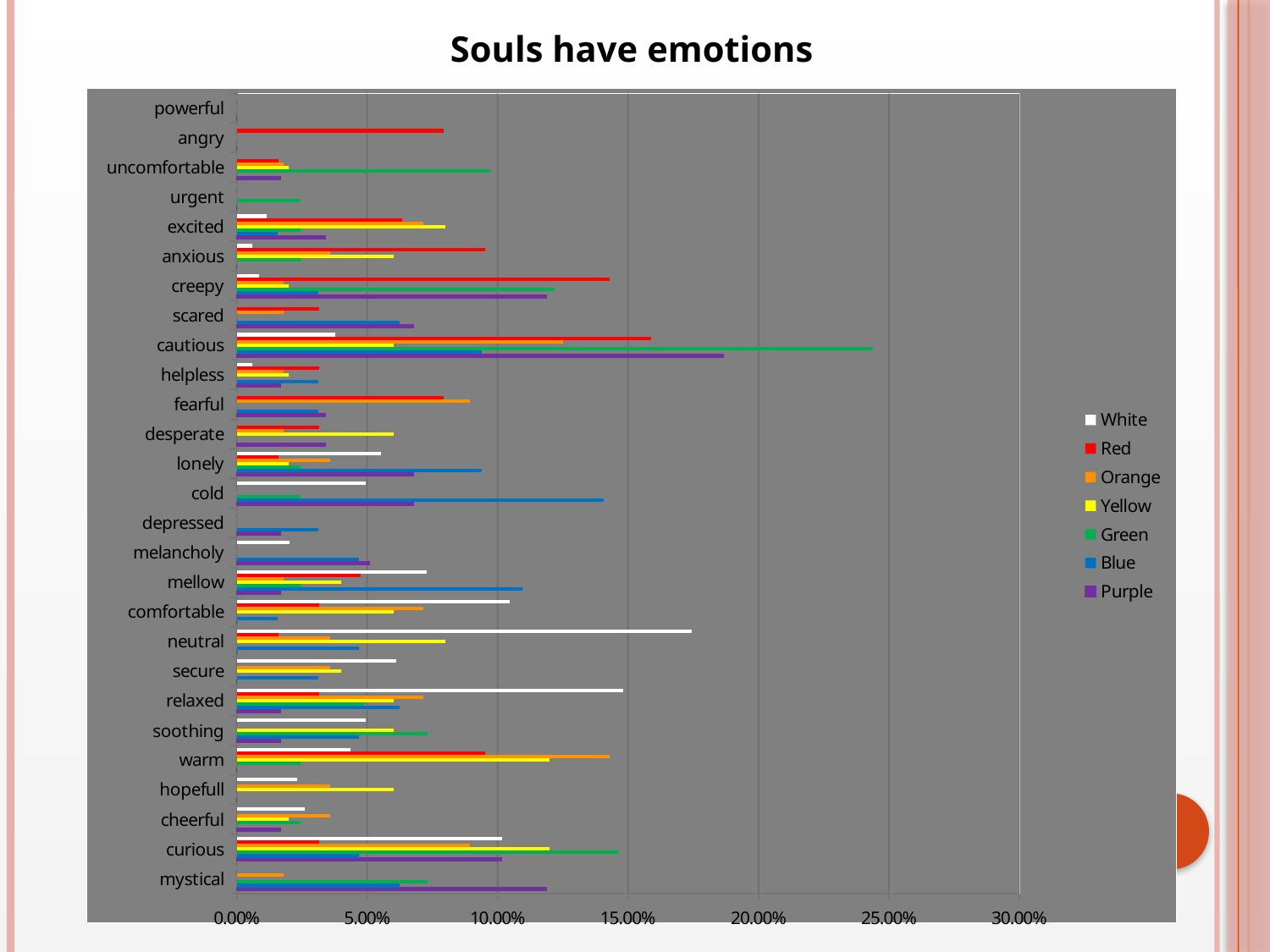
Is the Red value for angry greater or less than 10.00%? less What is the title of the chart? Souls have emotions For which emotion is the White series highest? neutral What kind of chart is shown on the slide? bar chart How many emotion categories are plotted on the chart? 27 Which is larger, the Green value for cautious or the Green value for curious? cautious Is the Blue value for cold greater or less than 10.00%? greater How many series does the legend list? 7 For which emotion is the Green series highest? cautious Is the Green value for cautious greater or less than 20.00%? greater Which series is listed last in the legend? Purple